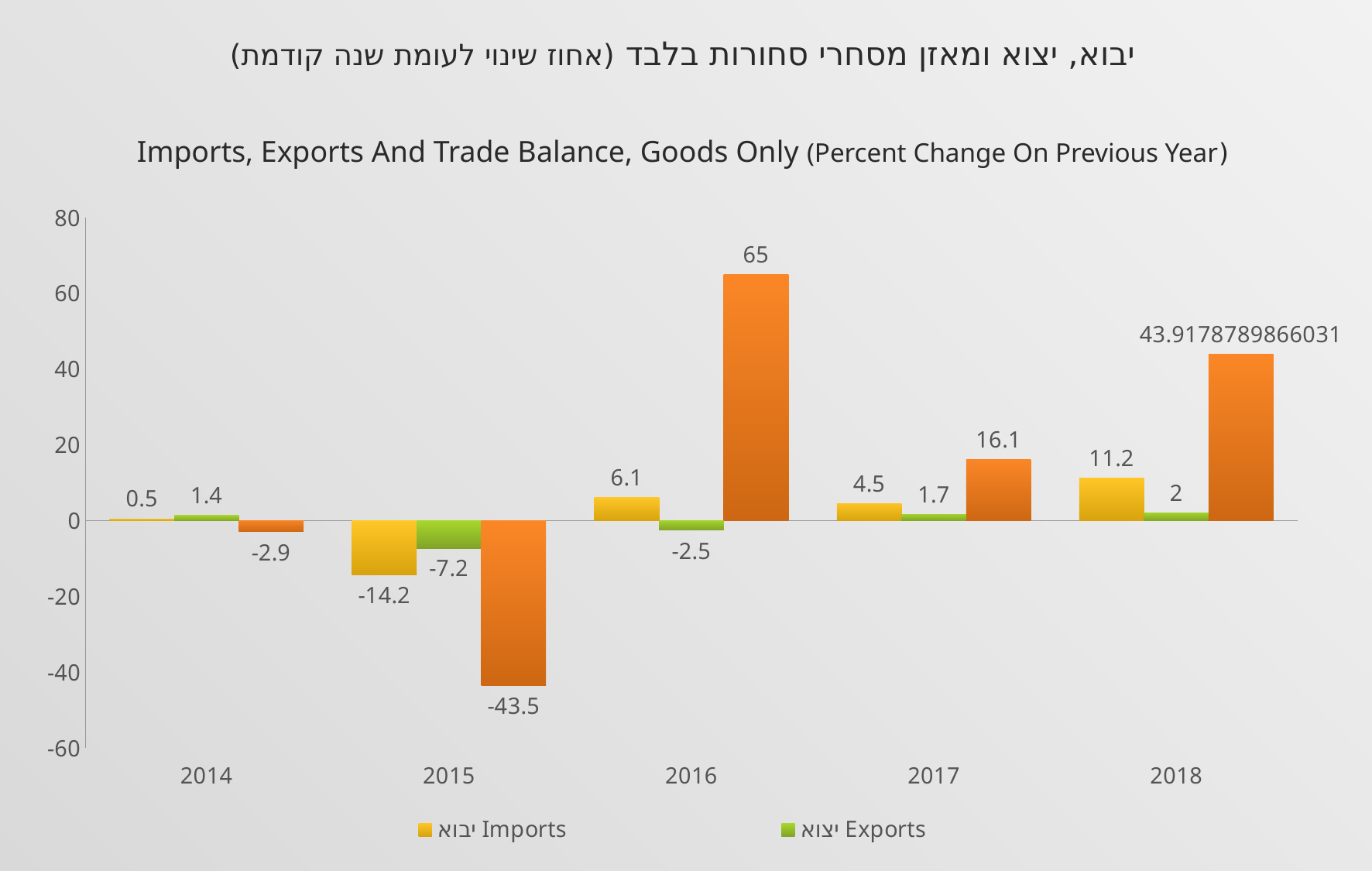
Which is larger for 2016: the Imports value or the Exports value? Imports What is the Imports value for 2018? 11.2 What is the Imports value for 2015? -14.2 How many series does the legend list? 2 In which year is the Imports value highest? 2018 Which colour represents Exports in the legend? green How many years are shown on the x axis? 5 What is the Exports value for 2017? 1.7 What kind of chart is shown on the slide? bar chart What is the value of the orange bar for 2016? 65 In which year is the Exports value lowest? 2015 What is the difference between the Imports value for 2018 and the Imports value for 2017? 6.7